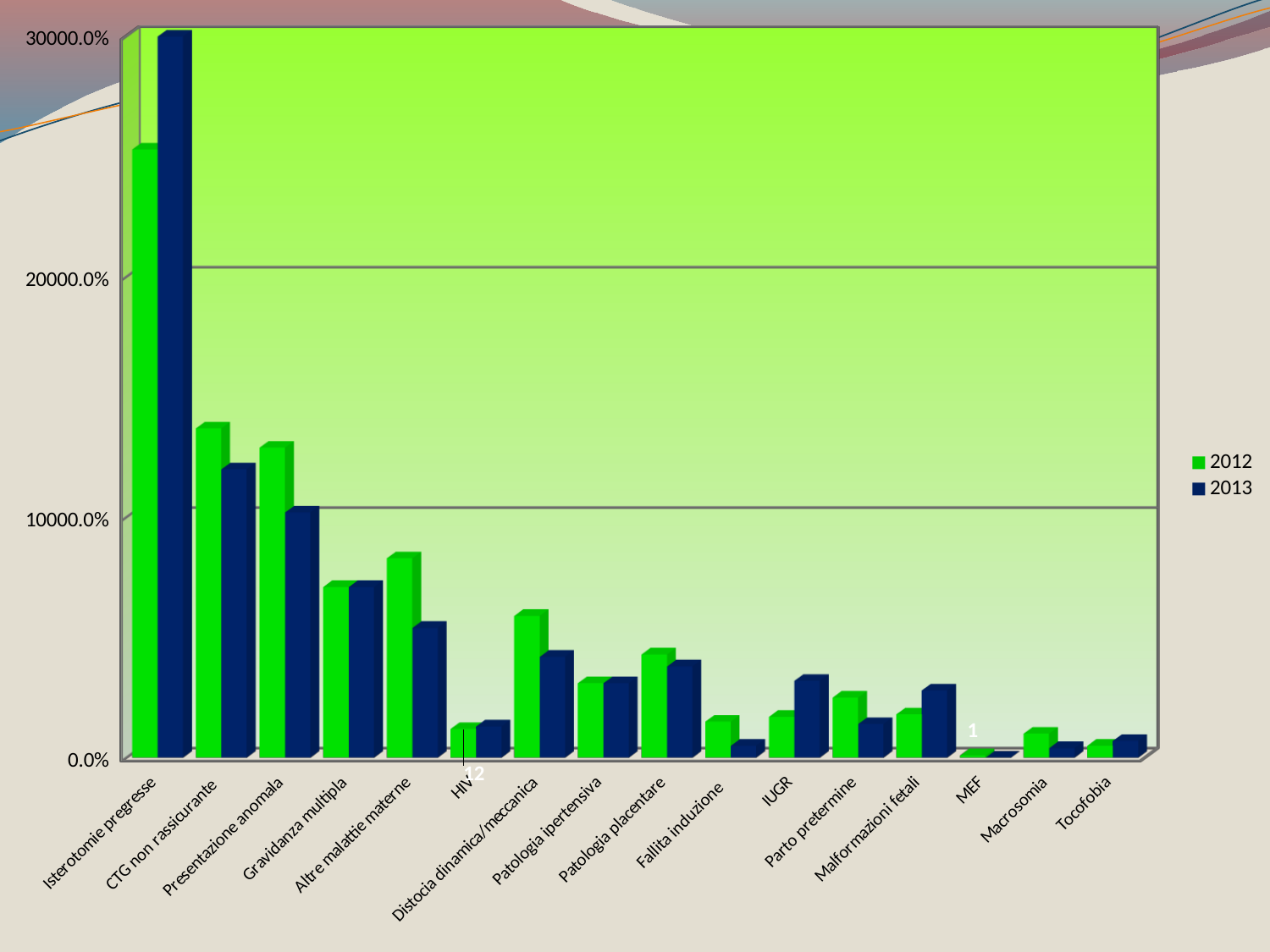
What are the two entries listed in the legend? 2012 and 2013 Which category has the highest value for the 2012 series? Isterotomie pregresse Which category has the lowest value for the 2012 series? MEF For IUGR, which series has the larger value, 2012 or 2013? 2013 Which category has the highest value for the 2013 series? Isterotomie pregresse For CTG non rassicurante, which series has the larger value, 2012 or 2013? 2012 Is the 2013 value for CTG non rassicurante greater or less than 20000.0%? less How many series does the legend list? 2 For Isterotomie pregresse, which series has the larger value, 2012 or 2013? 2013 Is the 2012 value for Isterotomie pregresse greater or less than 20000.0%? greater What kind of chart is shown on the slide? Bar chart How many categories are shown on the x axis? 16